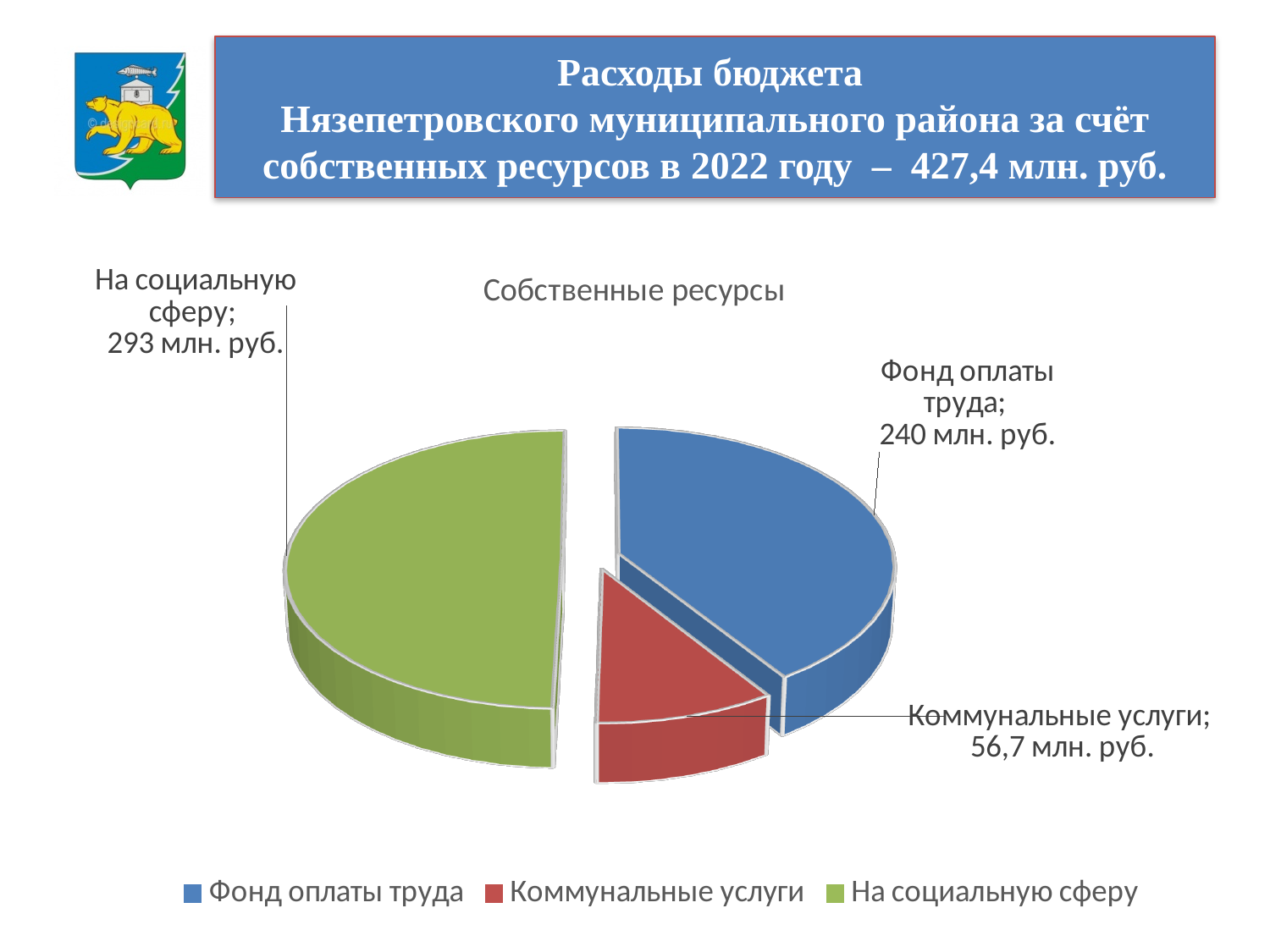
What is the value for На социальную сферу? 293 млн. руб. Which is larger: Фонд оплаты труда or Коммунальные услуги? Фонд оплаты труда How many categories does the pie chart have? 3 What is the title of the pie chart? Собственные ресурсы What is the difference between the values for На социальную сферу and Фонд оплаты труда? 53 млн. руб. Which category has the smallest slice of the pie? Коммунальные услуги What is the difference between the values for Фонд оплаты труда and Коммунальные услуги? 183,3 млн. руб. What colour is the slice for Коммунальные услуги? Red Which category has the largest slice of the pie? На социальную сферу What is the value for Коммунальные услуги? 56,7 млн. руб. What is the value for Фонд оплаты труда? 240 млн. руб. What type of chart is shown on the slide? Pie chart